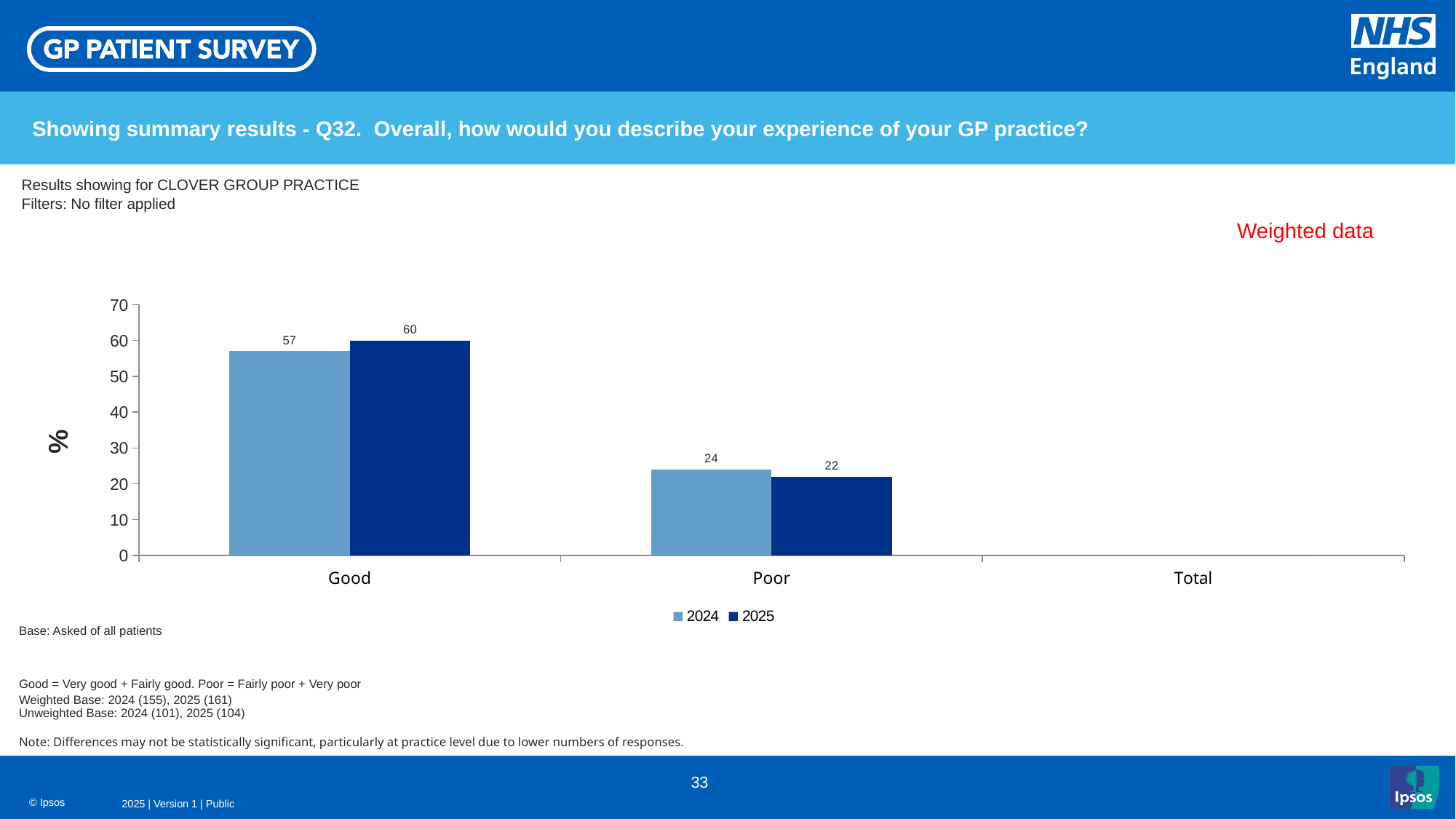
What is the difference between the 2024 and 2025 values for Poor? 2 What is the value for Poor in 2024? 24 What label is shown on the y axis of the chart? % Which category has the highest value in the 2025 series? Good What is the difference between the 2025 and 2024 values for Good? 3 How many series does the legend list? 2 Which is larger: the 2024 value for Poor or the 2025 value for Poor? 2024 What kind of chart is shown on the slide? Bar chart Which category has the lowest value in the 2024 series? Poor What is the value for Good in 2024? 57 What is the value for Good in 2025? 60 What is the value for Poor in 2025? 22